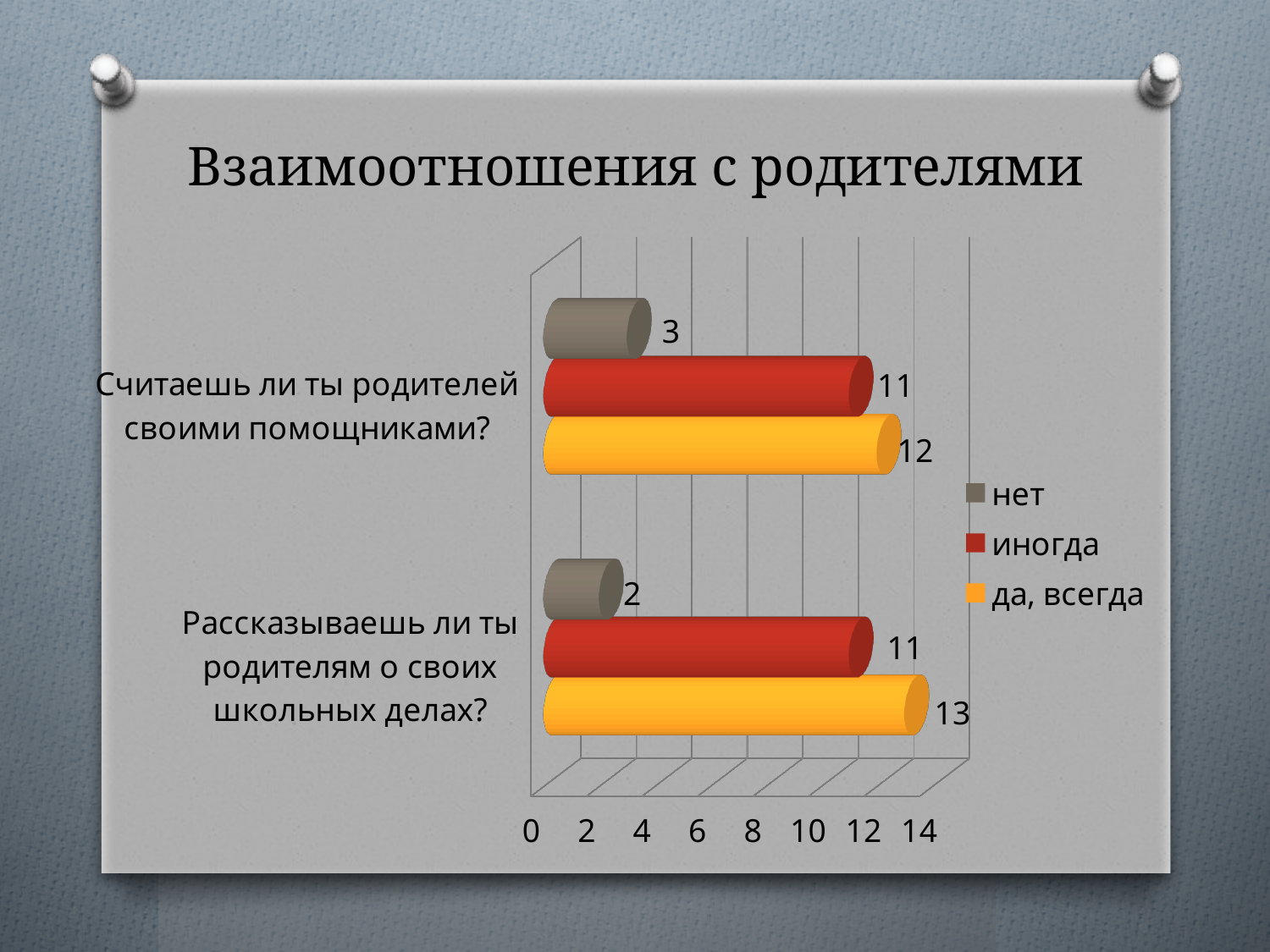
What is the value for "да, всегда" for the category "Считаешь ли ты родителей своими помощниками?"? 12 What is the value for "да, всегда" for the category "Рассказываешь ли ты родителям о своих школьных делах?"? 13 What is the value for "иногда" for the category "Считаешь ли ты родителей своими помощниками?"? 11 Which series has the highest value for the category "Рассказываешь ли ты родителям о своих школьных делах?"? да, всегда What is the value for "нет" for the category "Рассказываешь ли ты родителям о своих школьных делах?"? 2 What is the difference between the "да, всегда" and "нет" values for the category "Рассказываешь ли ты родителям о своих школьных делах?"? 11 Which series has the lowest value for the category "Считаешь ли ты родителей своими помощниками?"? нет How many categories are shown on the chart? 2 How many series does the legend list? 3 What kind of chart is shown on the slide? bar chart What is the title of the slide? Взаимоотношения с родителями Which is larger: the "нет" value for "Считаешь ли ты родителей своими помощниками?" or the "нет" value for "Рассказываешь ли ты родителям о своих школьных делах?"? Считаешь ли ты родителей своими помощниками?